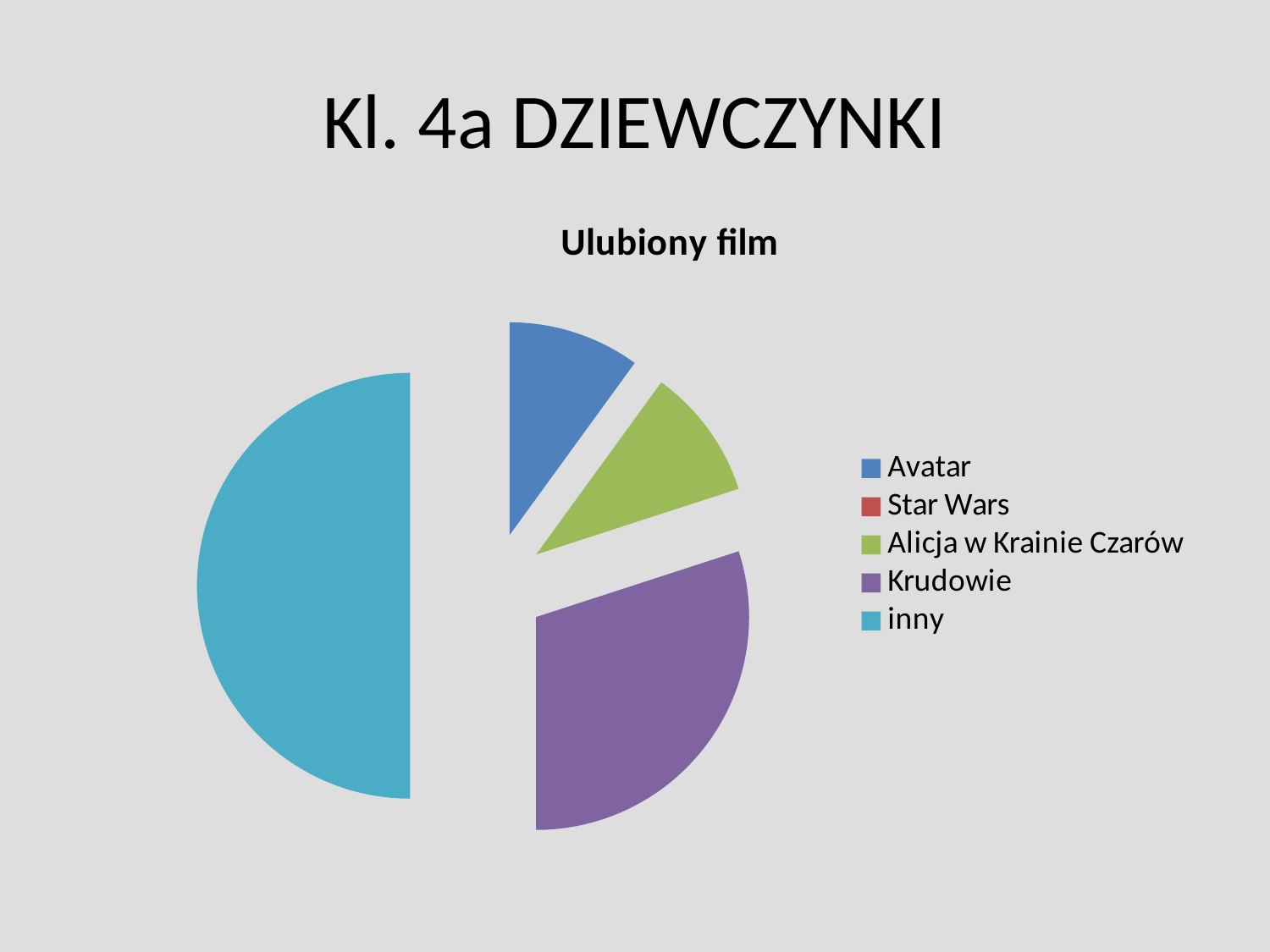
Which is larger, the slice for Krudowie or the slice for Avatar? Krudowie Which legend entry has no visible slice in the pie? Star Wars Which category has the largest slice of the pie? inny What kind of chart is shown on the slide? pie chart Which is larger, the slice for Krudowie or the slice for Alicja w Krainie Czarów? Krudowie What is the title of the chart? Ulubiony film How many slices are visible in the pie? 4 How many entries does the chart's legend list? 5 Which is larger, the slice for inny or the slice for Krudowie? inny What colour is the slice for Krudowie? purple